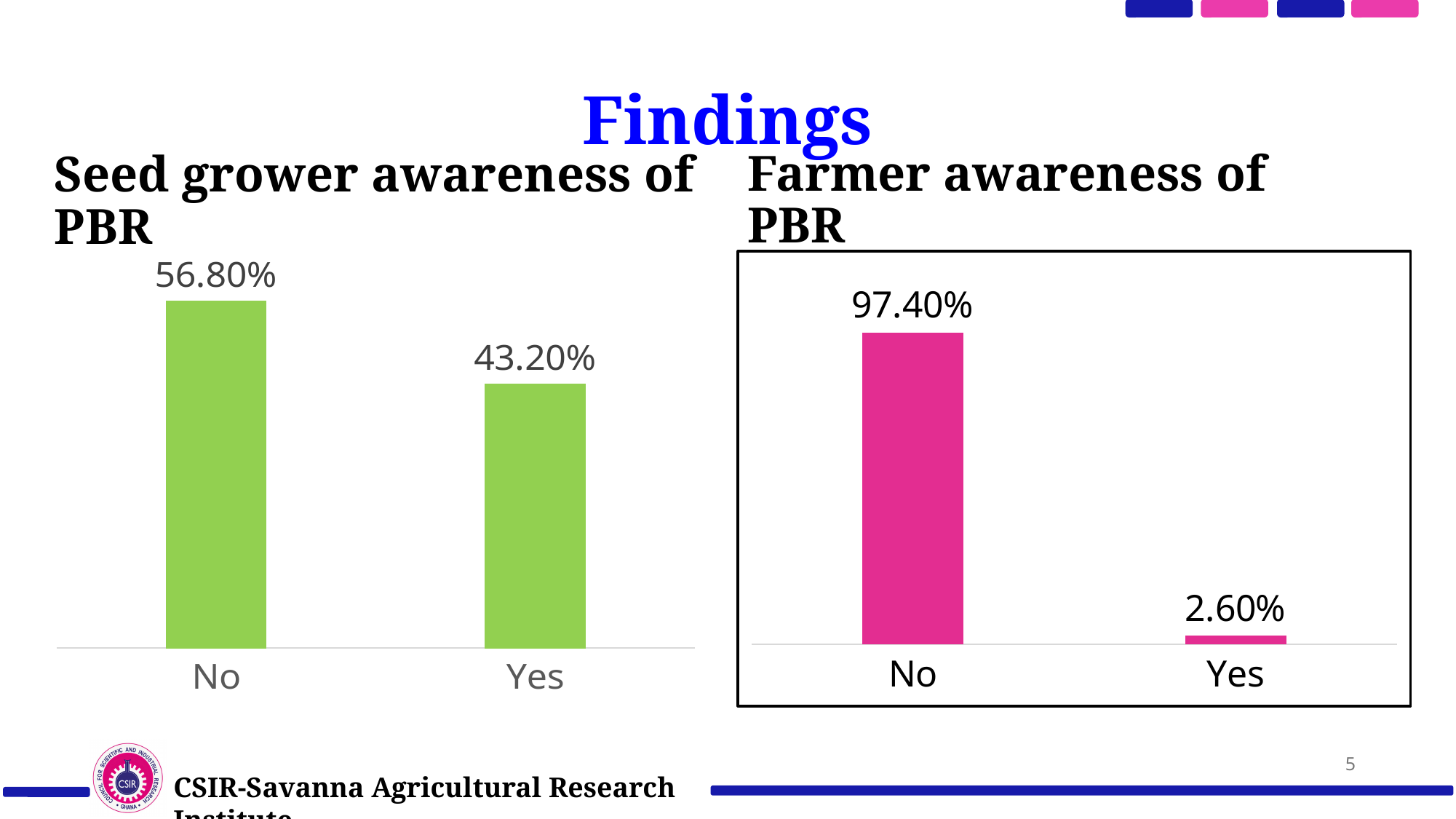
In the 'Seed grower awareness of PBR' chart, which category has the highest value? No In the 'Seed grower awareness of PBR' chart, what is the value for No? 56.80% In the 'Seed grower awareness of PBR' chart, what is the difference between the No and Yes values? 13.60% In the 'Farmer awareness of PBR' chart, what is the value for Yes? 2.60% What colour are the bars in the 'Farmer awareness of PBR' chart? pink In the 'Farmer awareness of PBR' chart, what is the difference between the No and Yes values? 94.80% How many categories are shown in the 'Farmer awareness of PBR' chart? 2 In the 'Farmer awareness of PBR' chart, which category has the lowest value? Yes In the 'Seed grower awareness of PBR' chart, what is the value for Yes? 43.20% Is the No value in the 'Farmer awareness of PBR' chart larger or smaller than the No value in the 'Seed grower awareness of PBR' chart? larger What kind of chart is the 'Seed grower awareness of PBR' chart? bar chart In the 'Farmer awareness of PBR' chart, what is the value for No? 97.40%